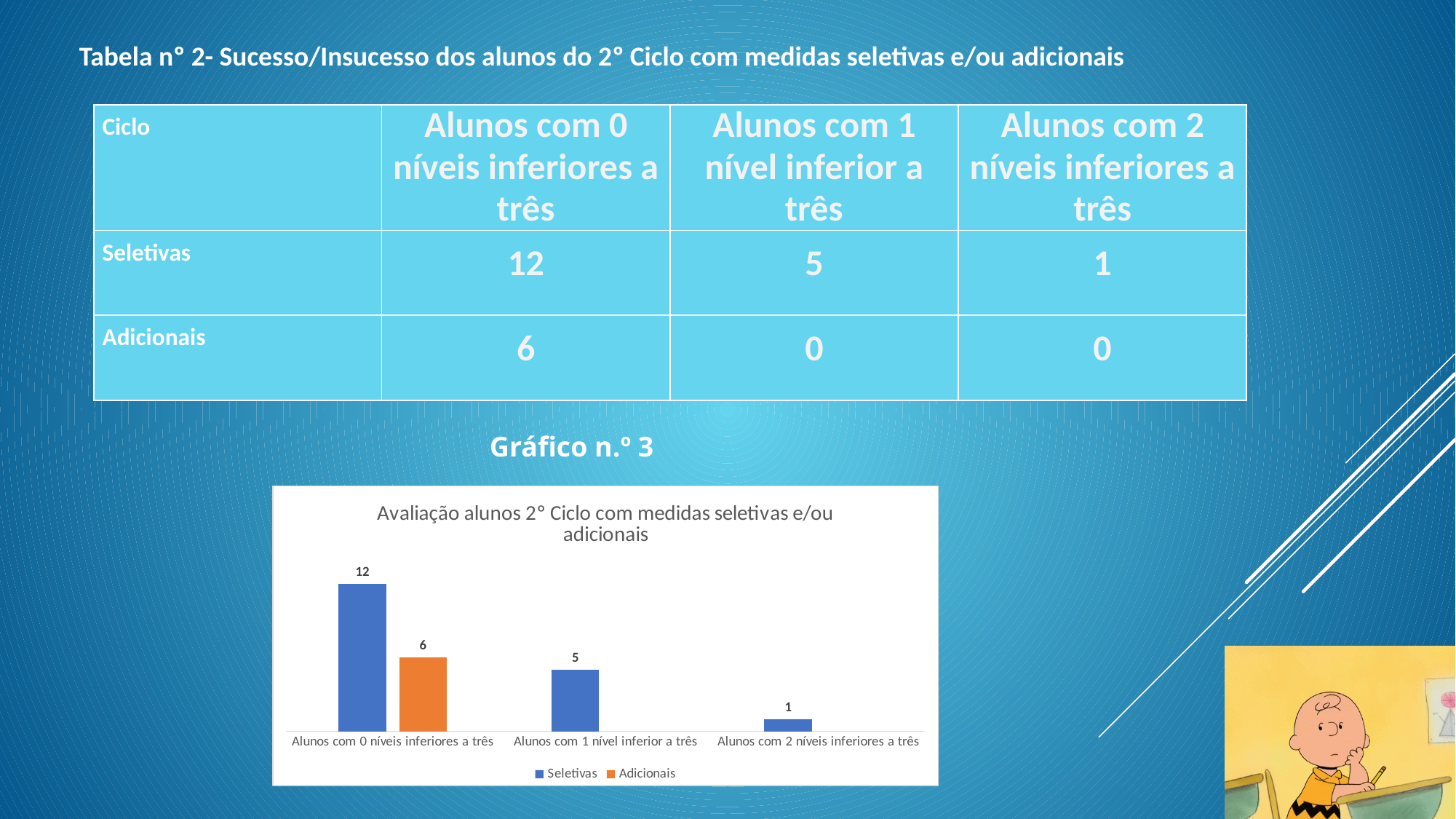
Which category has the highest value for Seletivas? Alunos com 0 níveis inferiores a três What is the title of the chart? Avaliação alunos 2° Ciclo com medidas seletivas e/ou adicionais What is the value for Seletivas in the category 'Alunos com 0 níveis inferiores a três'? 12 How many categories are shown on the x axis of the chart? 3 What kind of chart is shown on the slide? Bar chart How many series does the chart legend list? 2 What is the value for Seletivas in the category 'Alunos com 1 nível inferior a três'? 5 Which is larger in the category 'Alunos com 0 níveis inferiores a três': Seletivas or Adicionais? Seletivas Which category has the lowest value for Seletivas? Alunos com 2 níveis inferiores a três What is the difference between the Seletivas and Adicionais values in the category 'Alunos com 0 níveis inferiores a três'? 6 What is the value for Seletivas in the category 'Alunos com 2 níveis inferiores a três'? 1 What is the value for Adicionais in the category 'Alunos com 0 níveis inferiores a três'? 6